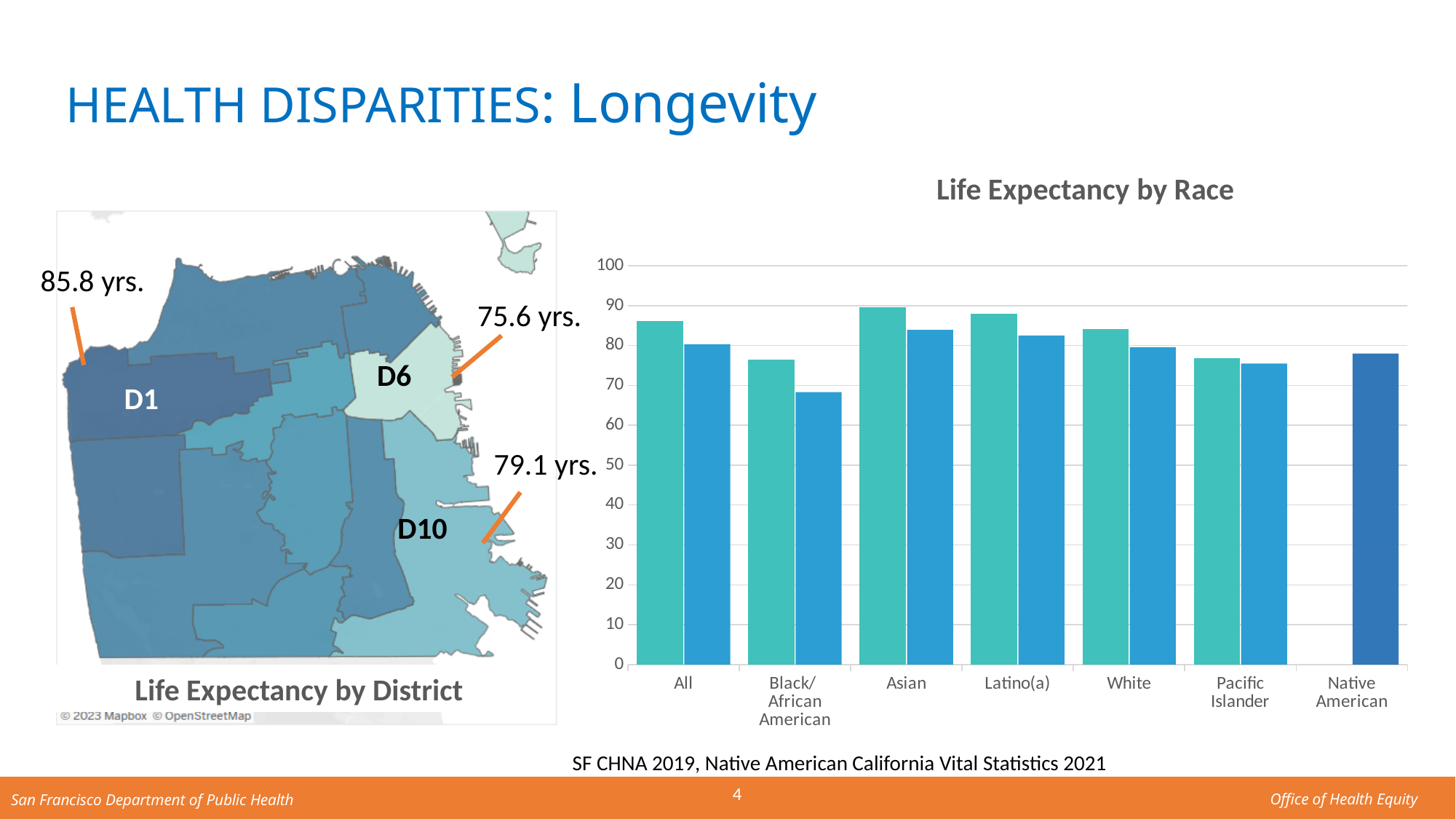
What kind of chart is the 'Life Expectancy by Race' chart? bar chart In the 'Life Expectancy by Race' chart, is the bar for Native American greater or less than 70? greater In the 'Life Expectancy by Race' chart, is the first (teal) bar for Pacific Islander greater or less than 80? less In the 'Life Expectancy by Race' chart, which category has the lowest bar? Black/African American In the 'Life Expectancy by Race' chart, which category has only a single bar? Native American How many race categories are shown on the x axis of the 'Life Expectancy by Race' chart? 7 In the 'Life Expectancy by Race' chart, which is larger: the first (teal) bar for Asian or the first (teal) bar for Black/African American? Asian In the 'Life Expectancy by Race' chart, which is larger: the second (blue) bar for White or the second (blue) bar for Black/African American? White In the 'Life Expectancy by Race' chart, is the second (blue) bar for Black/African American greater or less than 70? less In the 'Life Expectancy by District' map, what life expectancy is labelled for D1? 85.8 yrs. What is the title of the bar chart on the right of the slide? Life Expectancy by Race